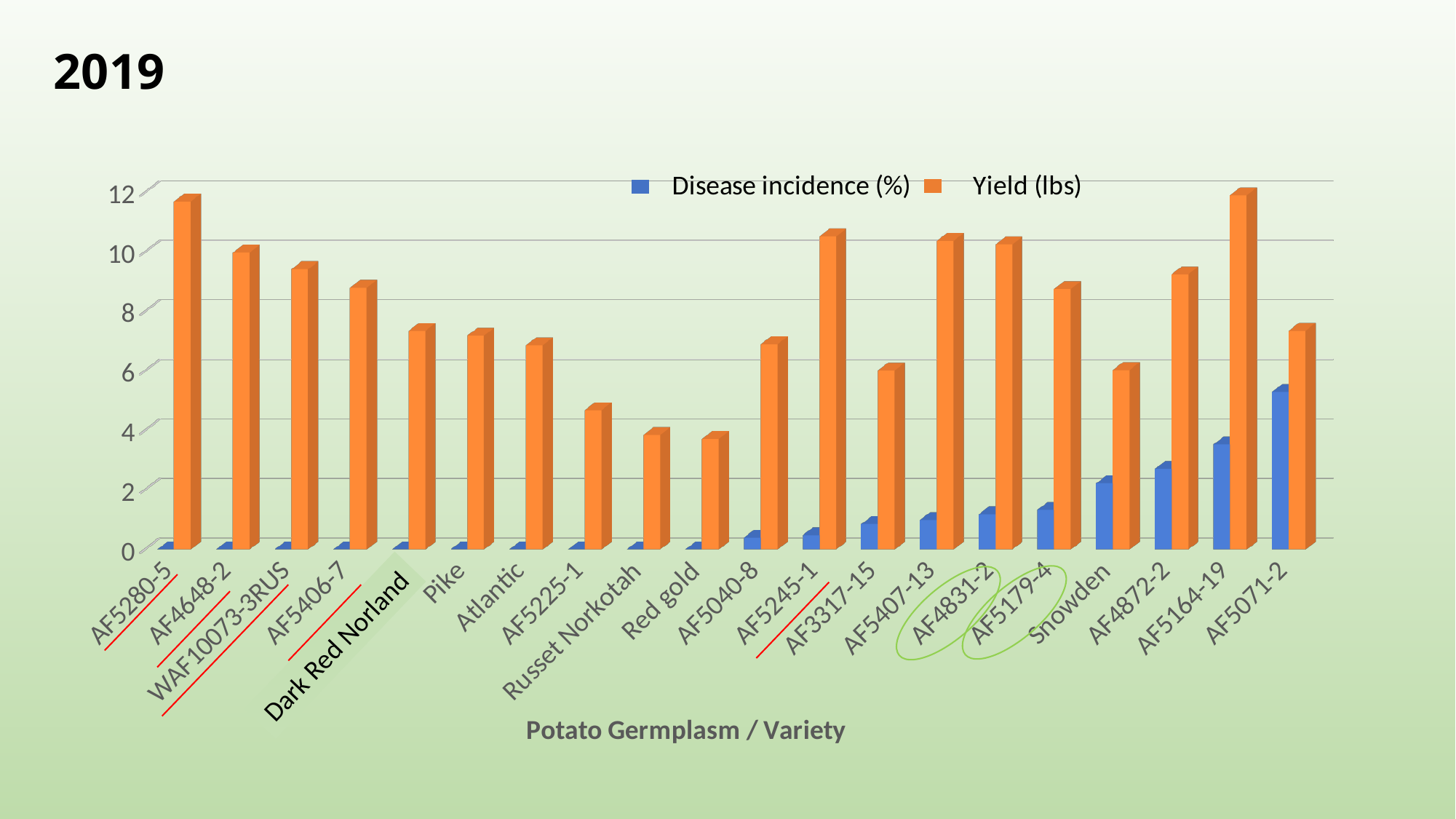
What kind of chart is shown on the slide? bar chart Which category has the highest Disease incidence (%)? AF5071-2 Which has the larger Disease incidence (%): Snowden or AF5164-19? AF5164-19 How many series does the legend list? 2 Which has the larger Yield (lbs): AF4648-2 or Pike? AF4648-2 Is the Yield (lbs) value for AF5280-5 greater or less than 10? greater Do the Disease incidence (%) values generally rise or fall from left to right along the x axis? rise What is the title of the x axis? Potato Germplasm / Variety Is the Yield (lbs) value for Red gold greater or less than 4? less Is the Disease incidence (%) value for AF5071-2 greater or less than 4? greater How many potato germplasm/variety categories are plotted on the x axis? 20